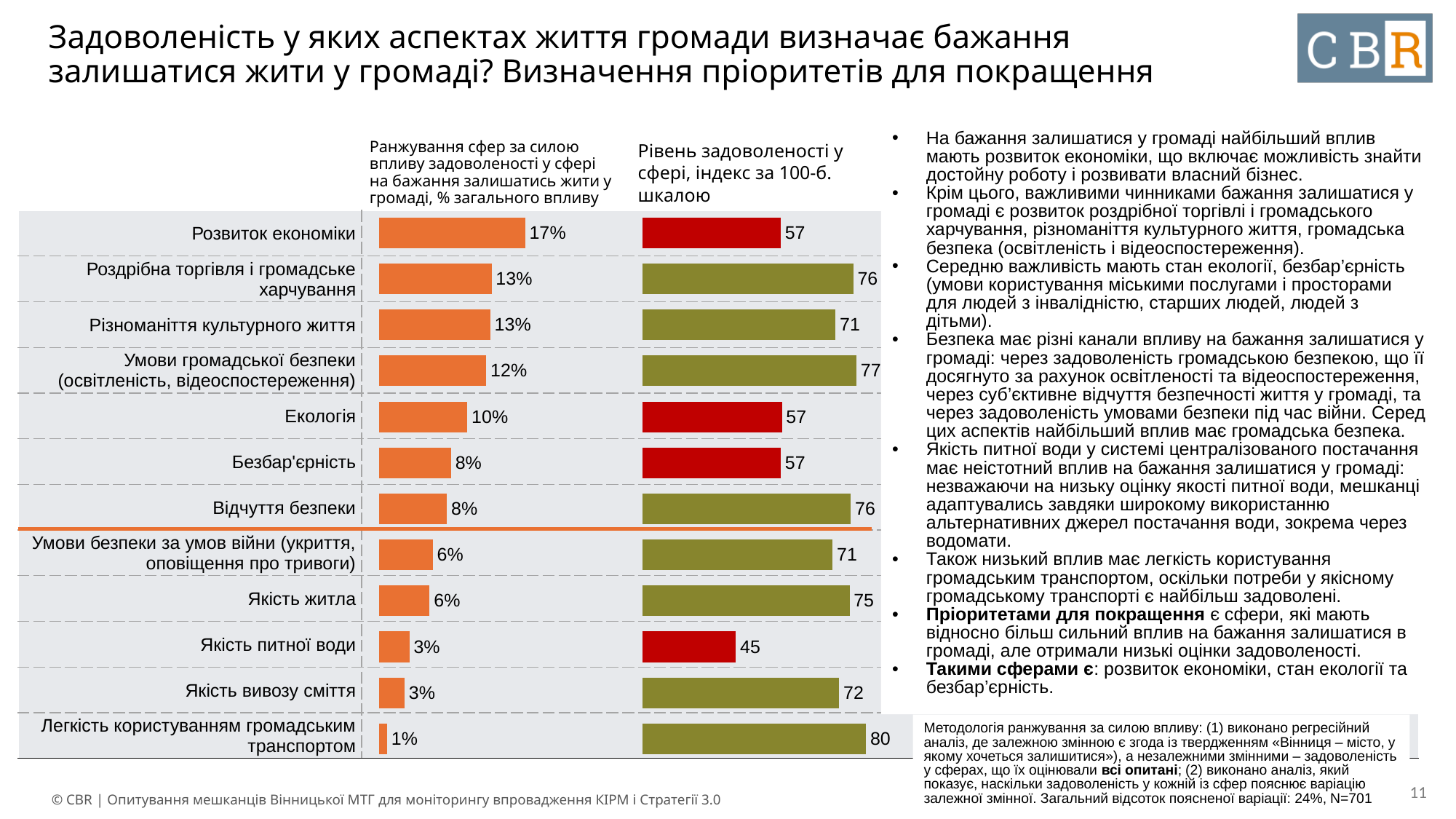
How many categories are shown in the left chart (Ранжування сфер за силою впливу)? 12 In the right chart (Рівень задоволеності у сфері), which category has the lowest satisfaction index? Якість питної води In the right chart (Рівень задоволеності у сфері), what is the difference between the satisfaction index for Умови громадської безпеки and Екологія? 20 In the left chart (Ранжування сфер за силою впливу), which has a larger value: Умови громадської безпеки or Безбар'єрність? Умови громадської безпеки In the left chart (Ранжування сфер за силою впливу), what is the value for Розвиток економіки? 17% In the right chart (Рівень задоволеності у сфері), which has a higher satisfaction index: Якість житла or Якість вивозу сміття? Якість житла In the left chart (Ранжування сфер за силою впливу), which category has the lowest share of influence? Легкість користуванням громадським транспортом In the left chart (Ранжування сфер за силою впливу), what is the difference between the values for Розвиток економіки and Екологія? 7% In the right chart (Рівень задоволеності у сфері), which category has the highest satisfaction index? Легкість користуванням громадським транспортом In the right chart (Рівень задоволеності у сфері), what is the satisfaction index for Якість питної води? 45 In the right chart (Рівень задоволеності у сфері), what colour are the bars for Розвиток економіки, Екологія, Безбар'єрність and Якість питної води? Red What type of chart is the right chart (Рівень задоволеності у сфері)? Bar chart